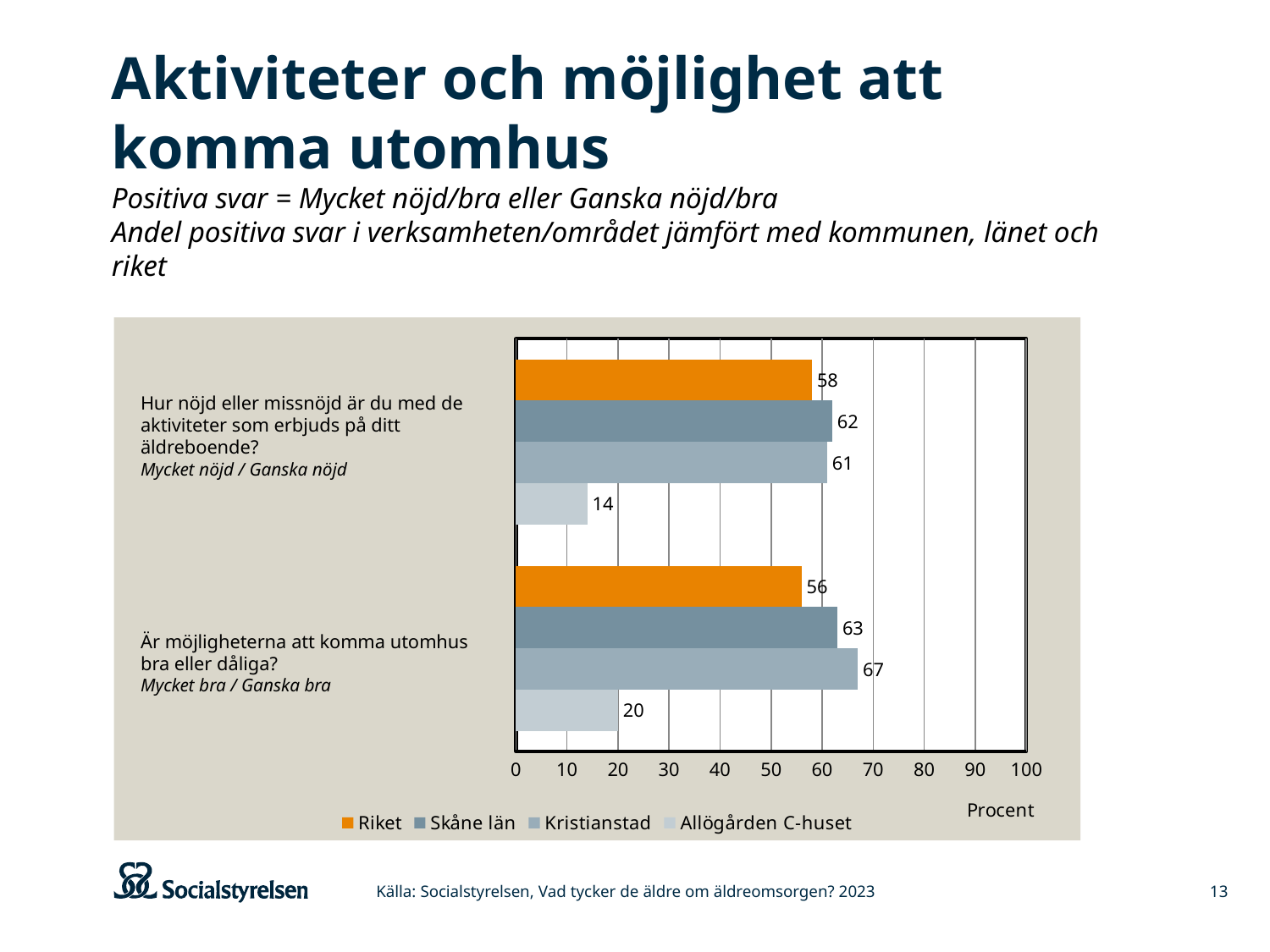
What is the value for Allögården C-huset on the question about satisfaction with activities offered at the care home (Hur nöjd eller missnöjd är du med de aktiviteter som erbjuds på ditt äldreboende?)? 14 Is the value for Allögården C-huset on the question about opportunities to get outdoors greater or less than 30? less How many series does the legend list? 4 What is the value for Kristianstad on the question about opportunities to get outdoors (Är möjligheterna att komma utomhus bra eller dåliga?)? 67 What kind of chart is shown on the slide? Bar chart What is the difference between Skåne län and Allögården C-huset on the question about satisfaction with activities offered at the care home? 48 What is the label of the x axis? Procent Which is larger on the question about opportunities to get outdoors: Riket or Kristianstad? Kristianstad What is the value for Skåne län on the question about opportunities to get outdoors? 63 Which series has the lowest value on the question about opportunities to get outdoors? Allögården C-huset Which series has the highest value on the question about opportunities to get outdoors? Kristianstad What is the value for Riket on the question about satisfaction with activities offered at the care home? 58